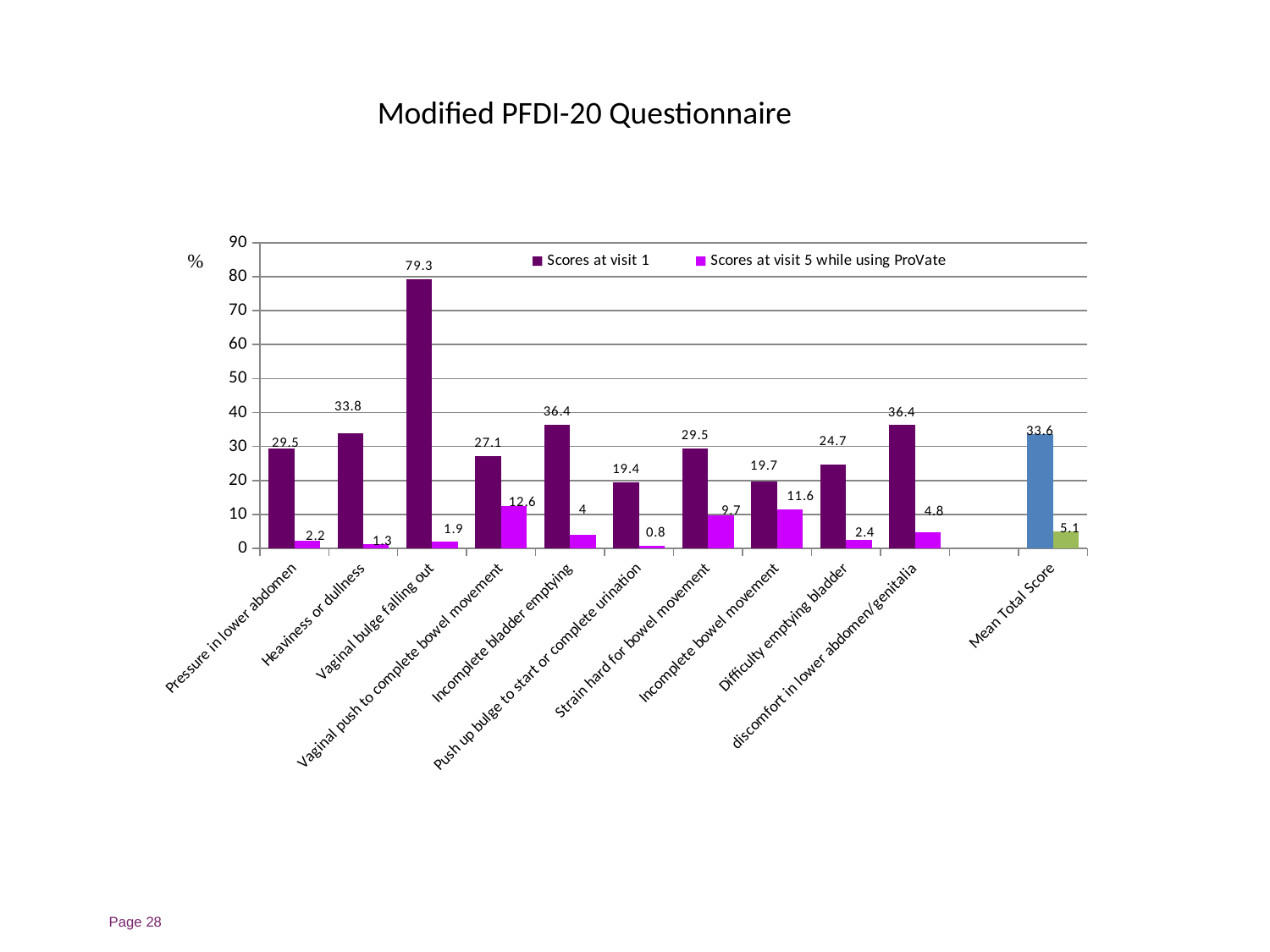
Is the visit 1 score for Difficulty emptying bladder greater or less than 20? greater What is the score at visit 5 while using ProVate for Vaginal push to complete bowel movement? 12.6 What is the Mean Total Score at visit 5 while using ProVate? 5.1 What kind of chart is shown on the slide? Bar chart How many categories are shown on the x axis? 11 Which category has the highest score at visit 1? Vaginal bulge falling out What is the score at visit 1 for Vaginal bulge falling out? 79.3 What is the difference between the visit 1 and visit 5 scores for Vaginal bulge falling out? 77.4 How many series does the legend list? 2 What is the difference between the visit 1 score for Heaviness or dullness and the visit 1 score for Pressure in lower abdomen? 4.3 Which is larger: the visit 5 score for Incomplete bowel movement or the visit 5 score for Strain hard for bowel movement? Incomplete bowel movement Which category has the lowest score at visit 5 while using ProVate? Push up bulge to start or complete urination